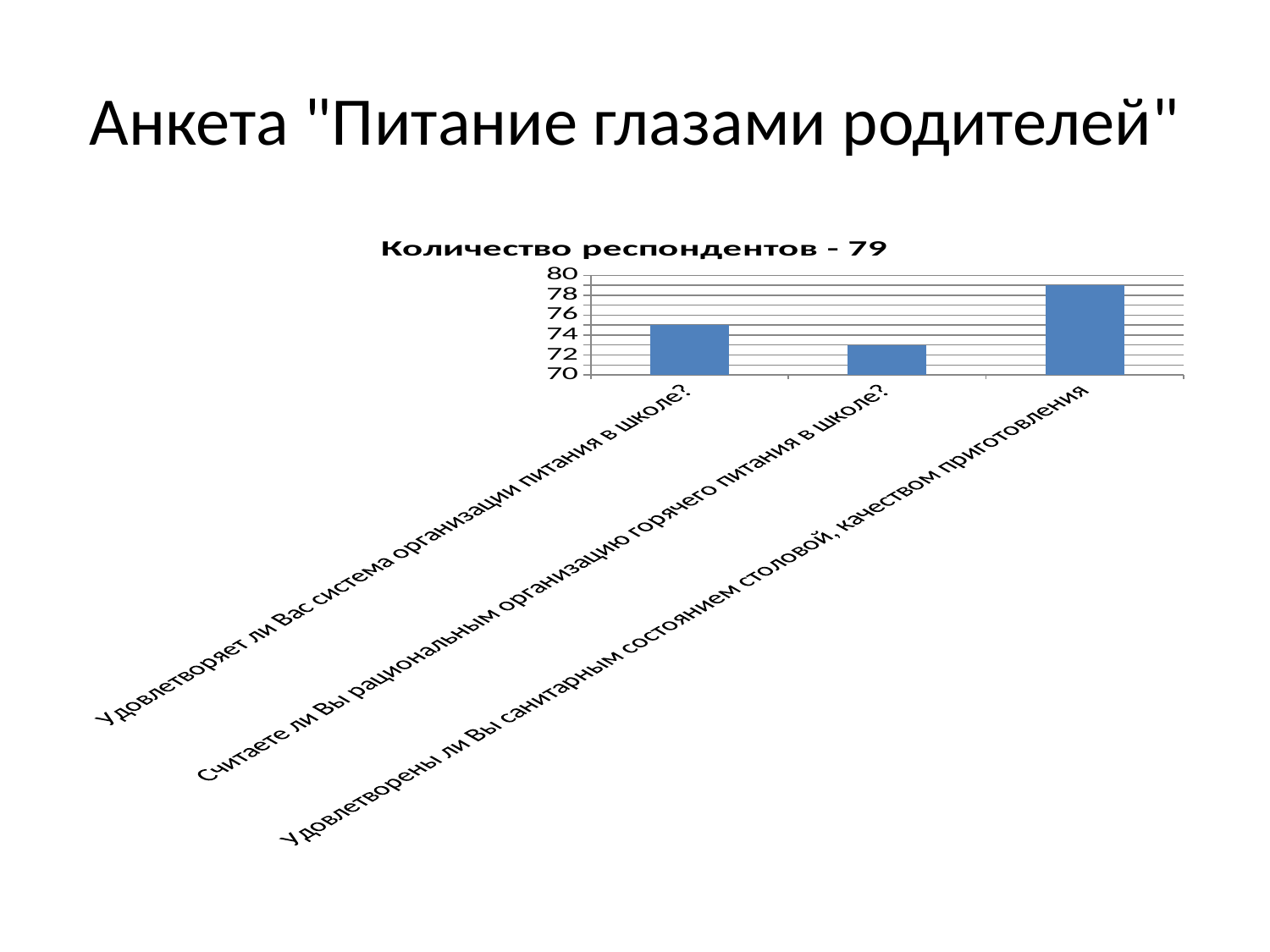
What is the lowest value shown on the vertical axis of the chart? 70 Which category has the lowest bar? Считаете ли Вы рациональным организацию горячего питания в школе? Which is larger: the value for "Удовлетворяет ли Вас система организации питания в школе?" or the value for "Считаете ли Вы рациональным организацию горячего питания в школе?"? Удовлетворяет ли Вас система организации питания в школе? What kind of chart is shown on the slide? bar chart What is the title of the chart? Количество респондентов - 79 Is the value for "Удовлетворяет ли Вас система организации питания в школе?" greater or less than 74? greater Is the value for "Удовлетворены ли Вы санитарным состоянием столовой, качеством приготовления" greater or less than 78? greater How many bars (categories) does the chart show? 3 Is the value for "Считаете ли Вы рациональным организацию горячего питания в школе?" greater or less than 74? less Which category has the highest bar? Удовлетворены ли Вы санитарным состоянием столовой, качеством приготовления Which is larger: the value for "Считаете ли Вы рациональным организацию горячего питания в школе?" or the value for "Удовлетворены ли Вы санитарным состоянием столовой, качеством приготовления"? Удовлетворены ли Вы санитарным состоянием столовой, качеством приготовления